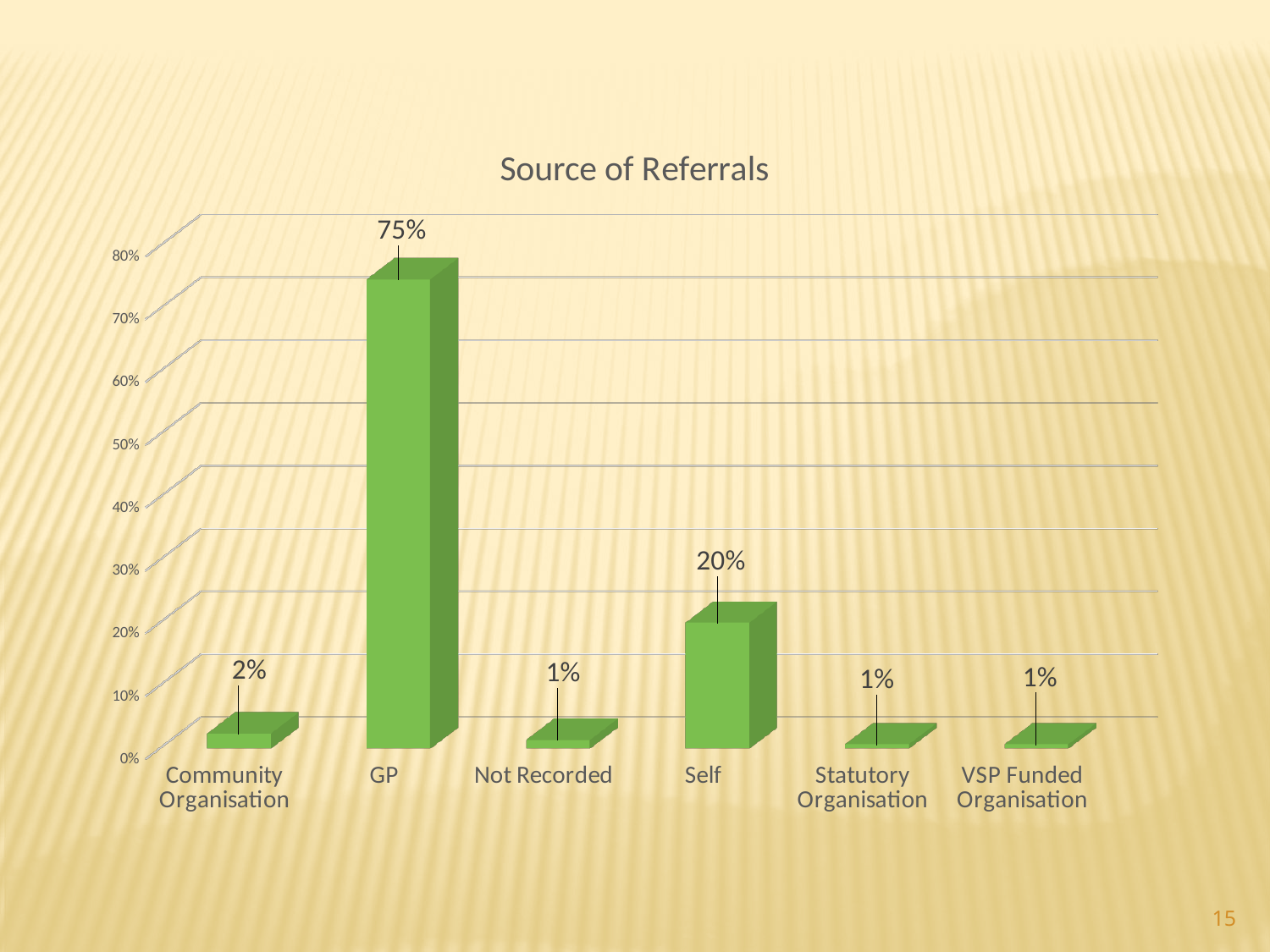
What is the value for Not Recorded? 1% Which category has the highest value? GP What is the difference between the values for Self and Community Organisation? 18% What is the value for Community Organisation? 2% What is the difference between the values for GP and Self? 55% What is the title of the chart? Source of Referrals Is the value for GP greater or less than 70%? greater What kind of chart is shown on the slide? bar chart What is the value for Self? 20% Which is larger, the value for Self or the value for Community Organisation? Self What is the value for GP? 75% How many categories are shown on the x axis? 6